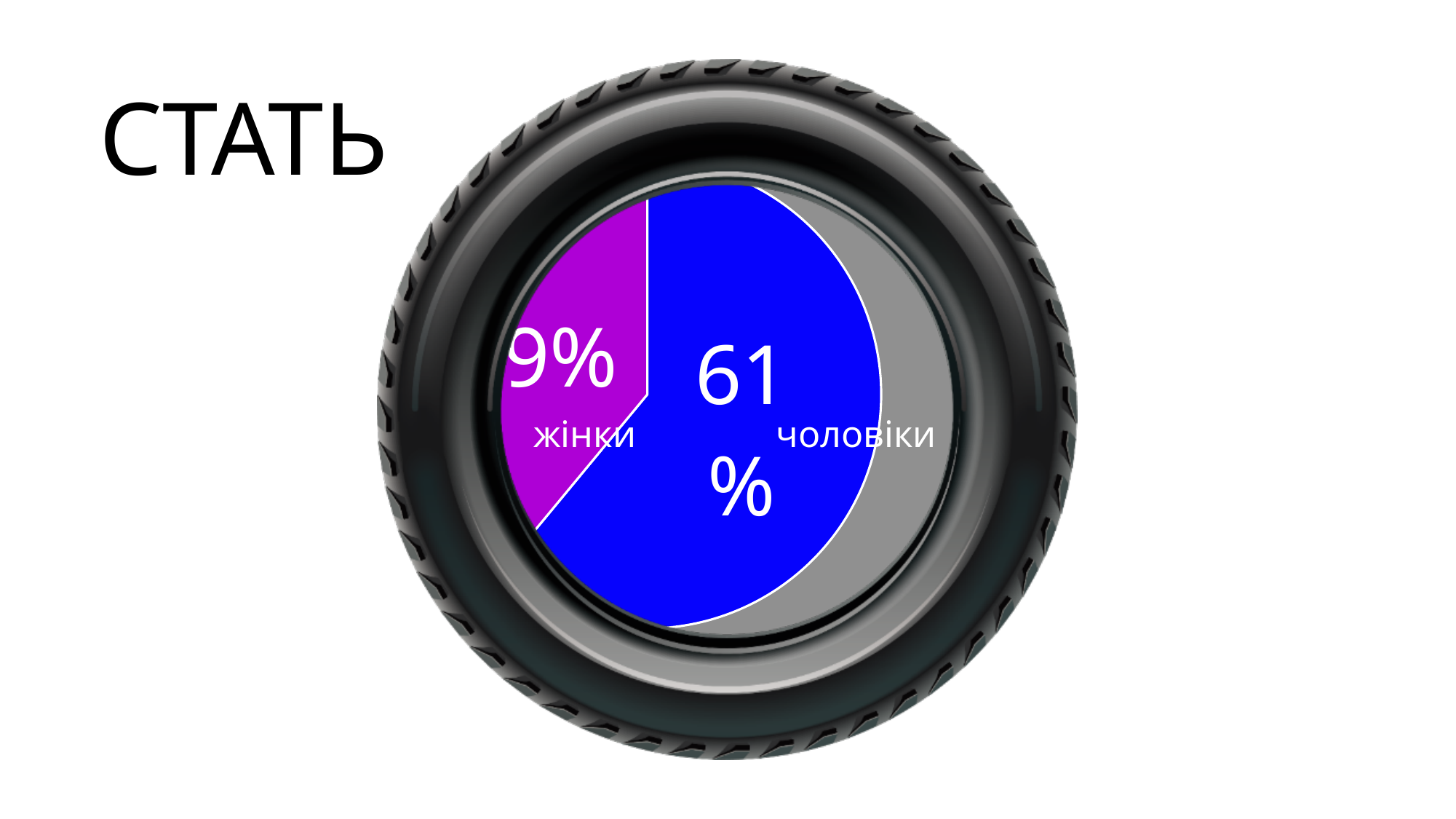
What percentage does the pie chart show for чоловіки? 61% What is the title of the slide containing the pie chart? СТАТЬ What kind of chart is shown on the slide? pie chart Which category has the largest slice in the pie chart? чоловіки How many categories are shown in the pie chart? 2 What share of the pie does the чоловіки slice represent? 61% What colour is the чоловіки slice in the pie chart? blue Which slice is larger, жінки or чоловіки? чоловіки Which category has the smallest slice in the pie chart? жінки